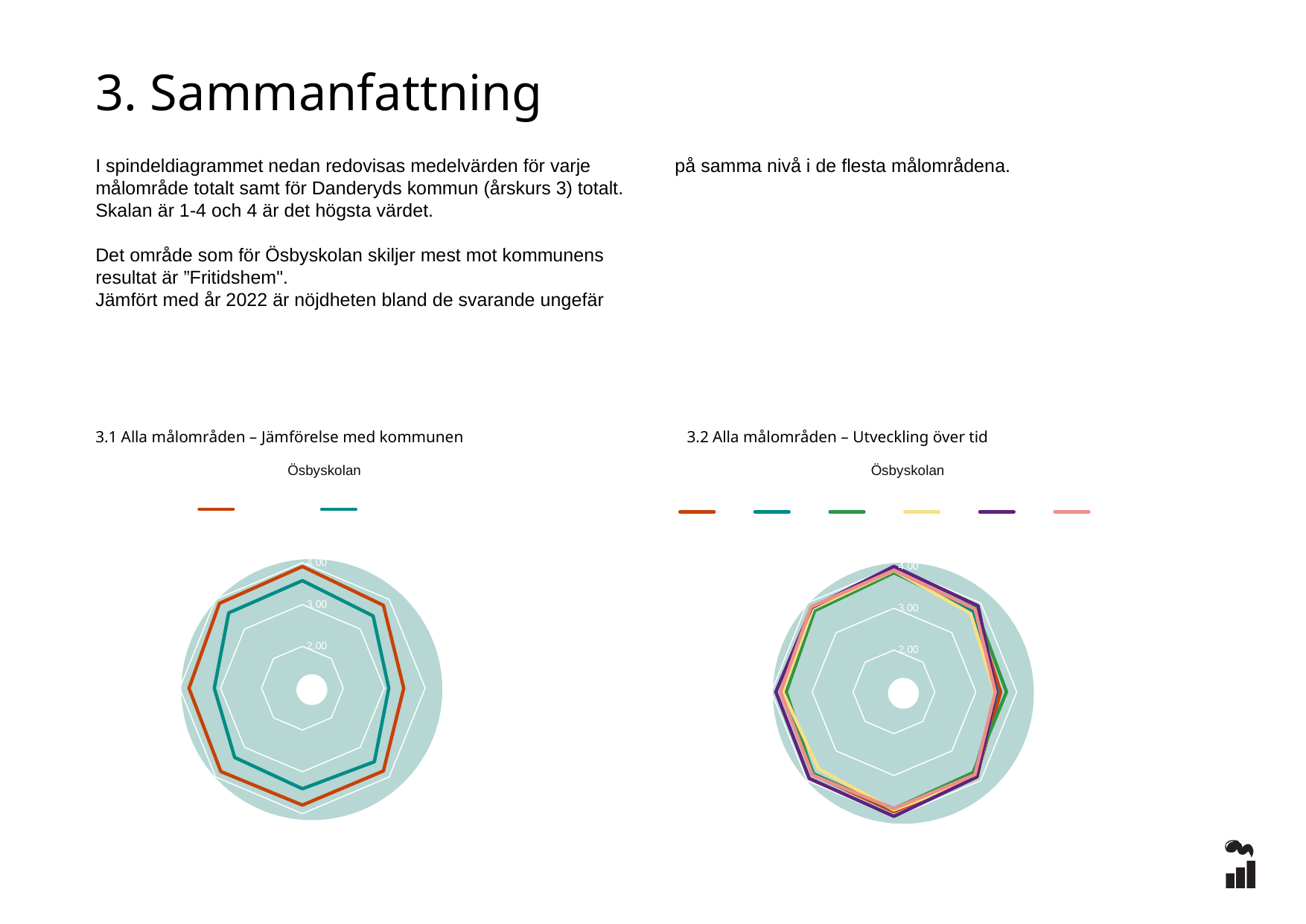
How many series does the legend of the chart "3.2 Alla målområden – Utveckling över tid" show? 6 In the chart "3.1 Alla målområden – Jämförelse med kommunen", which series has the larger values overall, the orange one or the teal one? The orange one How many series does the legend of the chart "3.1 Alla målområden – Jämförelse med kommunen" show? 2 In the chart "3.1 Alla målområden – Jämförelse med kommunen", are the values of the orange series greater or less than 3.00? greater What school name appears as the subtitle above both radar charts? Ösbyskolan What is the highest value shown on the scale of the chart "3.2 Alla målområden – Utveckling över tid"? 4.00 How many axes (spokes) does the radar chart "3.1 Alla målområden – Jämförelse med kommunen" have? 8 What kind of chart is the chart titled "3.1 Alla målområden – Jämförelse med kommunen"? Radar chart What kind of chart is the chart titled "3.2 Alla målområden – Utveckling över tid"? Radar chart